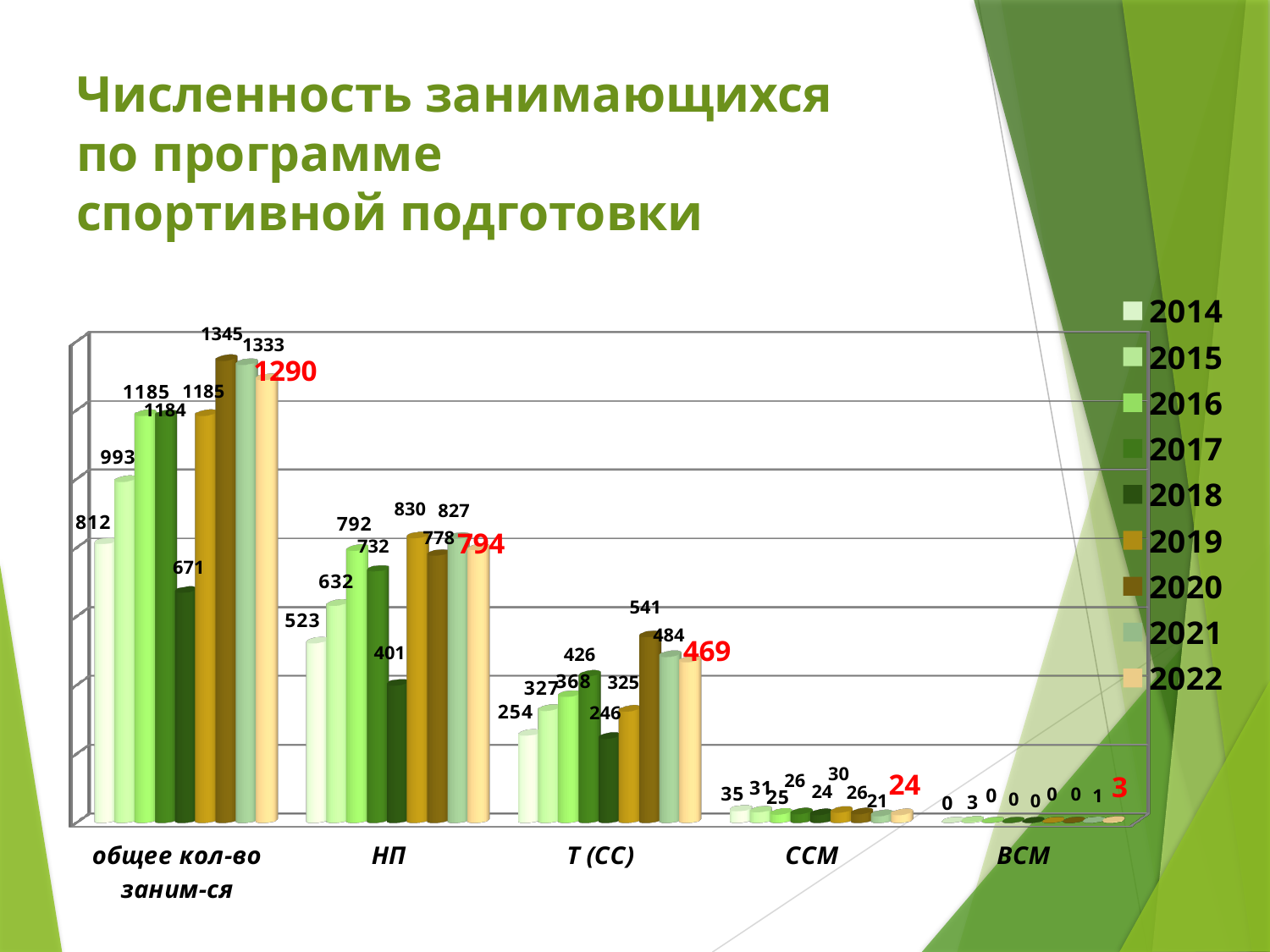
How many categories are shown on the x axis? 5 Which year has the lowest value in the "НП" category? 2018 How many series does the legend list? 9 Which year has the highest value in the "общее кол-во заним-ся" category? 2020 What is the value for 2020 in the "общее кол-во заним-ся" category? 1345 What is the value for 2022 in the "НП" category? 794 What kind of chart is shown on the slide? bar chart What is the value for 2014 in the "ССМ" category? 35 Which is larger in the "НП" category: the value for 2019 or the value for 2020? 2019 What is the difference between the 2020 and 2022 values in the "Т (СС)" category? 72 What is the value for 2018 in the "Т (СС)" category? 246 What is the value for 2022 in the "ВСМ" category? 3